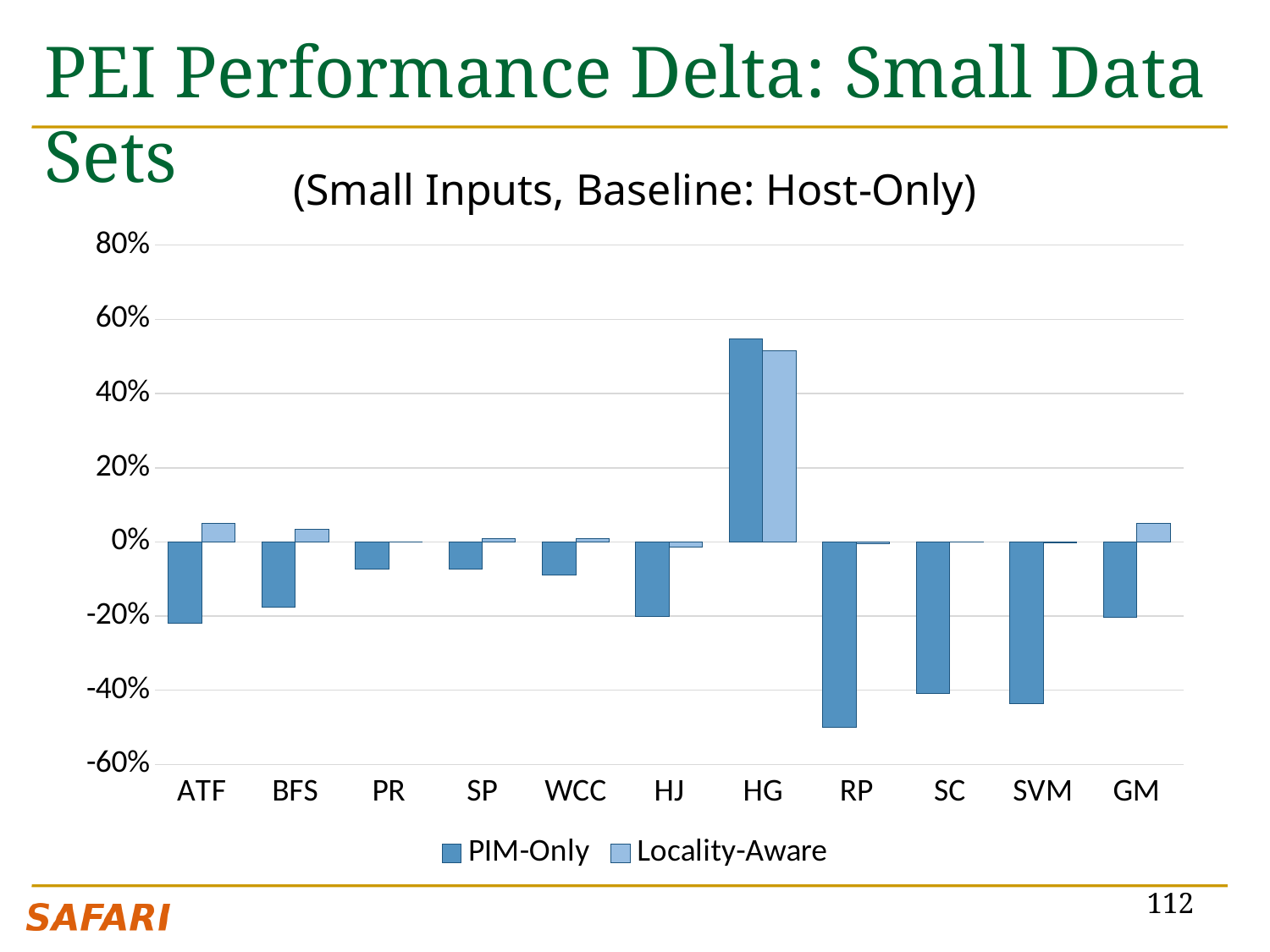
Is the PIM-Only value for HG greater or less than 40%? greater Is the PIM-Only value for RP greater or less than -40%? less How many categories are shown on the x axis? 11 What is the subtitle shown above the chart? (Small Inputs, Baseline: Host-Only) What kind of chart is shown on the slide? bar chart Which category has the highest Locality-Aware value? HG How many series does the legend list? 2 Which category has the highest PIM-Only value? HG For HG, which series has the larger value, PIM-Only or Locality-Aware? PIM-Only Is the PIM-Only value for HJ greater or less than -40%? greater Which category has the lowest PIM-Only value? RP Which is lower, the PIM-Only value for SVM or the PIM-Only value for BFS? SVM